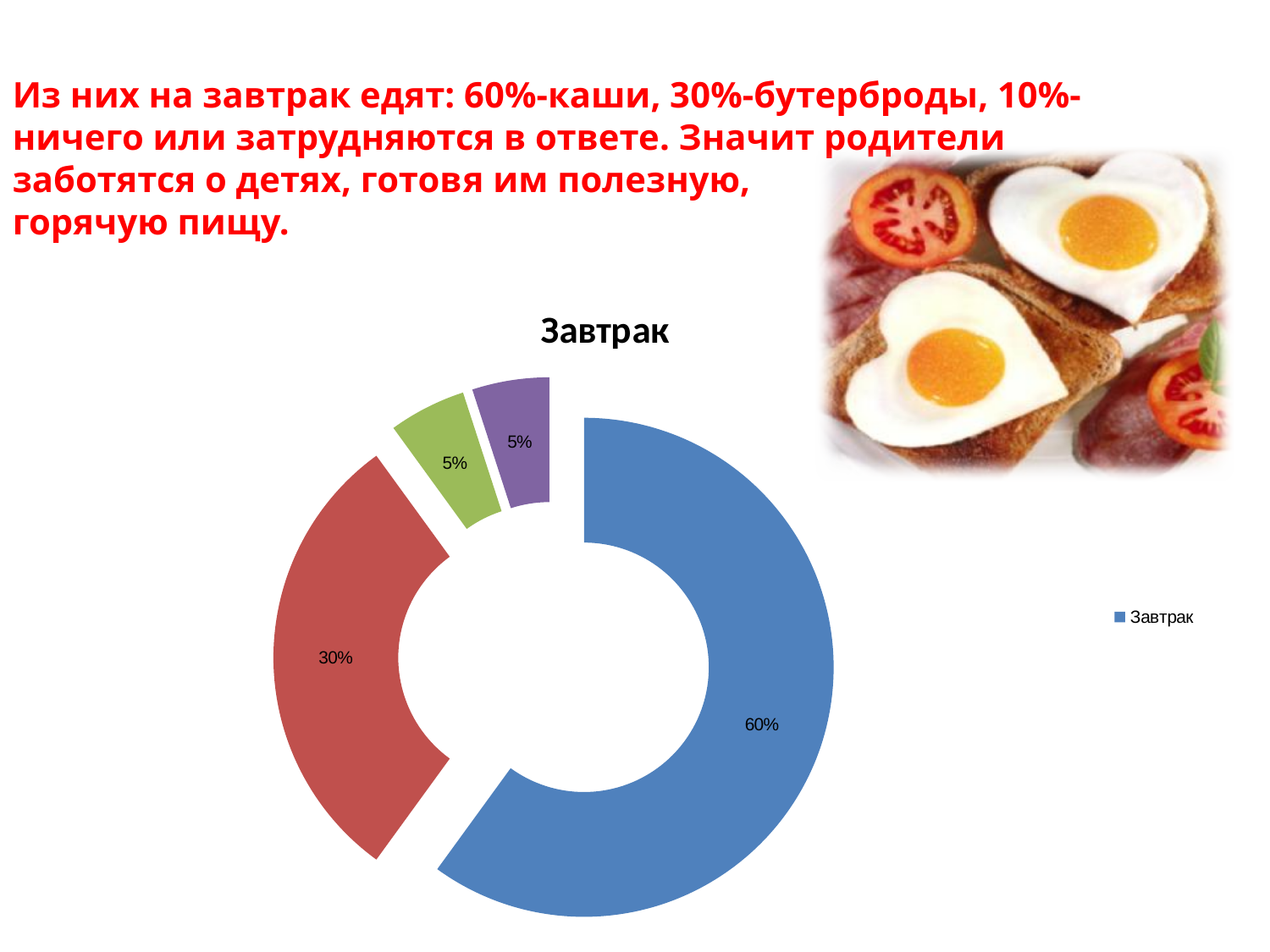
What kind of chart is shown on the slide? Doughnut (pie) chart What value is shown on the green slice of the chart? 5% What is the value of the largest slice of the chart? 60% How many slices does the chart have? 4 What is the difference between the blue slice and the red slice of the chart? 30 percentage points What value is shown on the blue slice of the chart? 60% What is the title of the chart? Завтрак What value is shown on the red slice of the chart? 30% What value is shown on the purple slice of the chart? 5% How many entries does the chart legend list? 1 Which slice is larger, the blue one or the red one? The blue one What is the value of the smallest slices of the chart? 5%